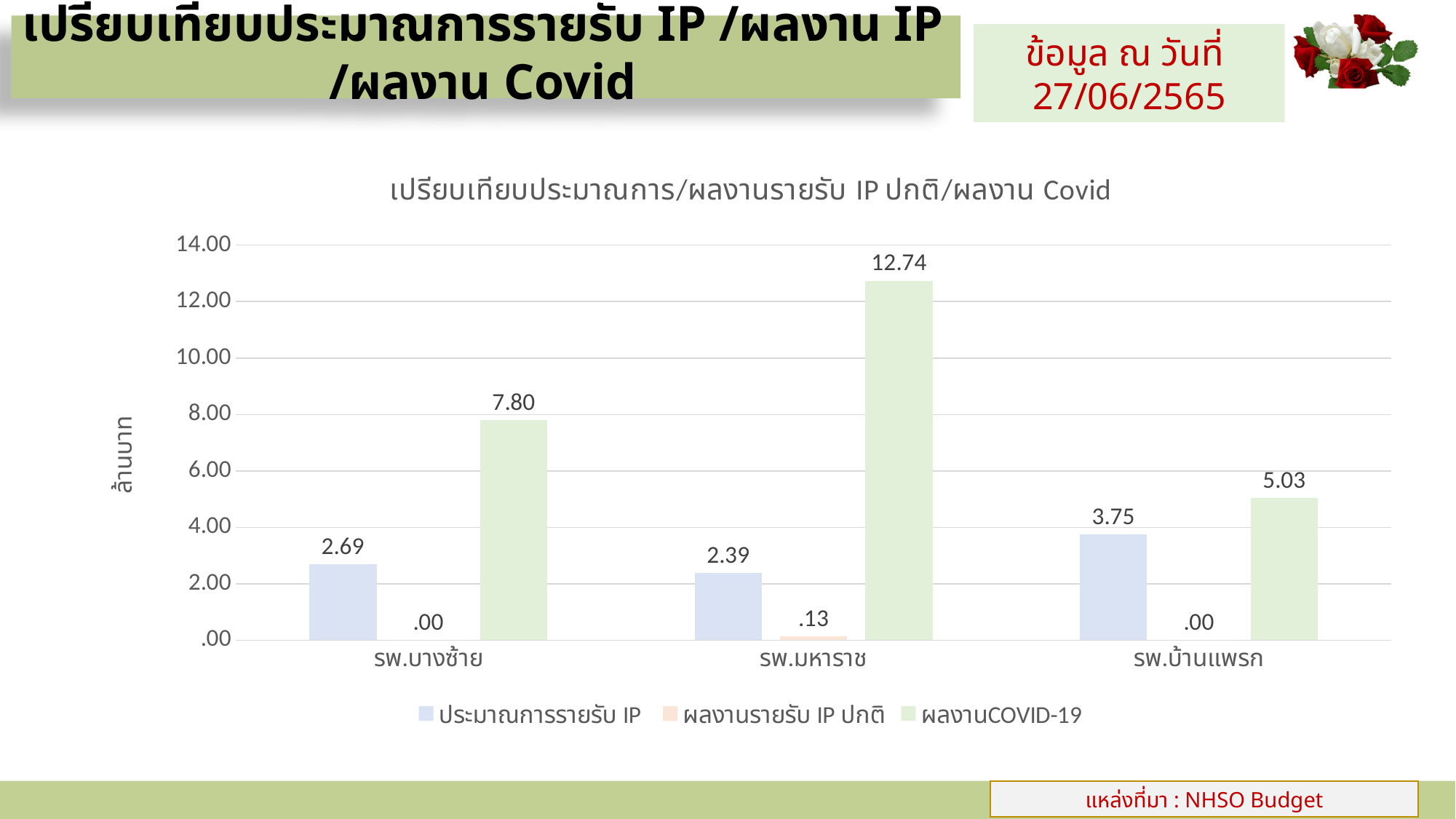
What is the value of ผลงานCOVID-19 for รพ.มหาราช? 12.74 What is the label of the y axis of the chart? ล้านบาท Which hospital has the highest ผลงานCOVID-19 value? รพ.มหาราช What is the value of ผลงานรายรับ IP ปกติ for รพ.มหาราช? .13 What is the value of ประมาณการรายรับ IP for รพ.บ้านแพรก? 3.75 How many series does the chart legend list? 3 Which is larger for รพ.บางซ้าย: ประมาณการรายรับ IP or ผลงานCOVID-19? ผลงานCOVID-19 How many hospitals are shown on the x axis of the chart? 3 What is the difference between ผลงานCOVID-19 and ประมาณการรายรับ IP for รพ.บ้านแพรก? 1.28 What is the value of ผลงานCOVID-19 for รพ.บางซ้าย? 7.80 What type of chart is shown on the slide? Bar chart Which hospital has the lowest ประมาณการรายรับ IP value? รพ.มหาราช